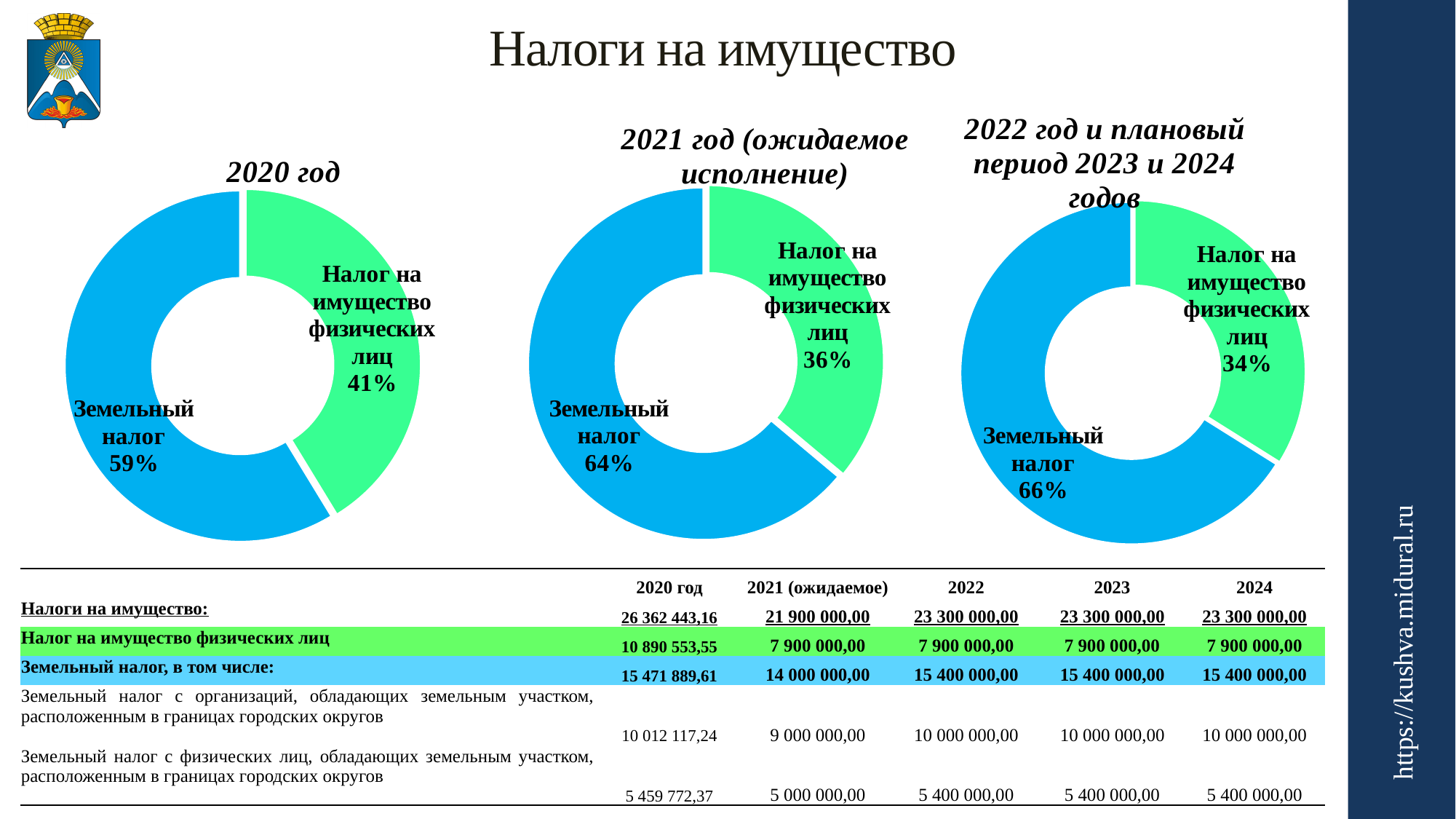
In the "2020 год" chart, what share does "Налог на имущество физических лиц" have? 41% What type of chart is the "2020 год" chart? Doughnut chart In the "2020 год" chart, what share does "Земельный налог" have? 59% In the "2022 год и плановый период 2023 и 2024 годов" chart, what is the value for "Земельный налог"? 66% In the "2022 год и плановый период 2023 и 2024 годов" chart, what is the value for "Налог на имущество физических лиц"? 34% In the "2022 год и плановый период 2023 и 2024 годов" chart, which category has the smallest share? Налог на имущество физических лиц In the "2020 год" chart, which category has the largest share? Земельный налог In the "2020 год" chart, which is larger: "Земельный налог" or "Налог на имущество физических лиц"? Земельный налог How many categories does the "2021 год (ожидаемое исполнение)" chart show? 2 In the "2021 год (ожидаемое исполнение)" chart, what is the value for "Налог на имущество физических лиц"? 36% In the "2021 год (ожидаемое исполнение)" chart, what is the value for "Земельный налог"? 64% In the "2021 год (ожидаемое исполнение)" chart, what is the difference in percentage points between "Земельный налог" and "Налог на имущество физических лиц"? 28